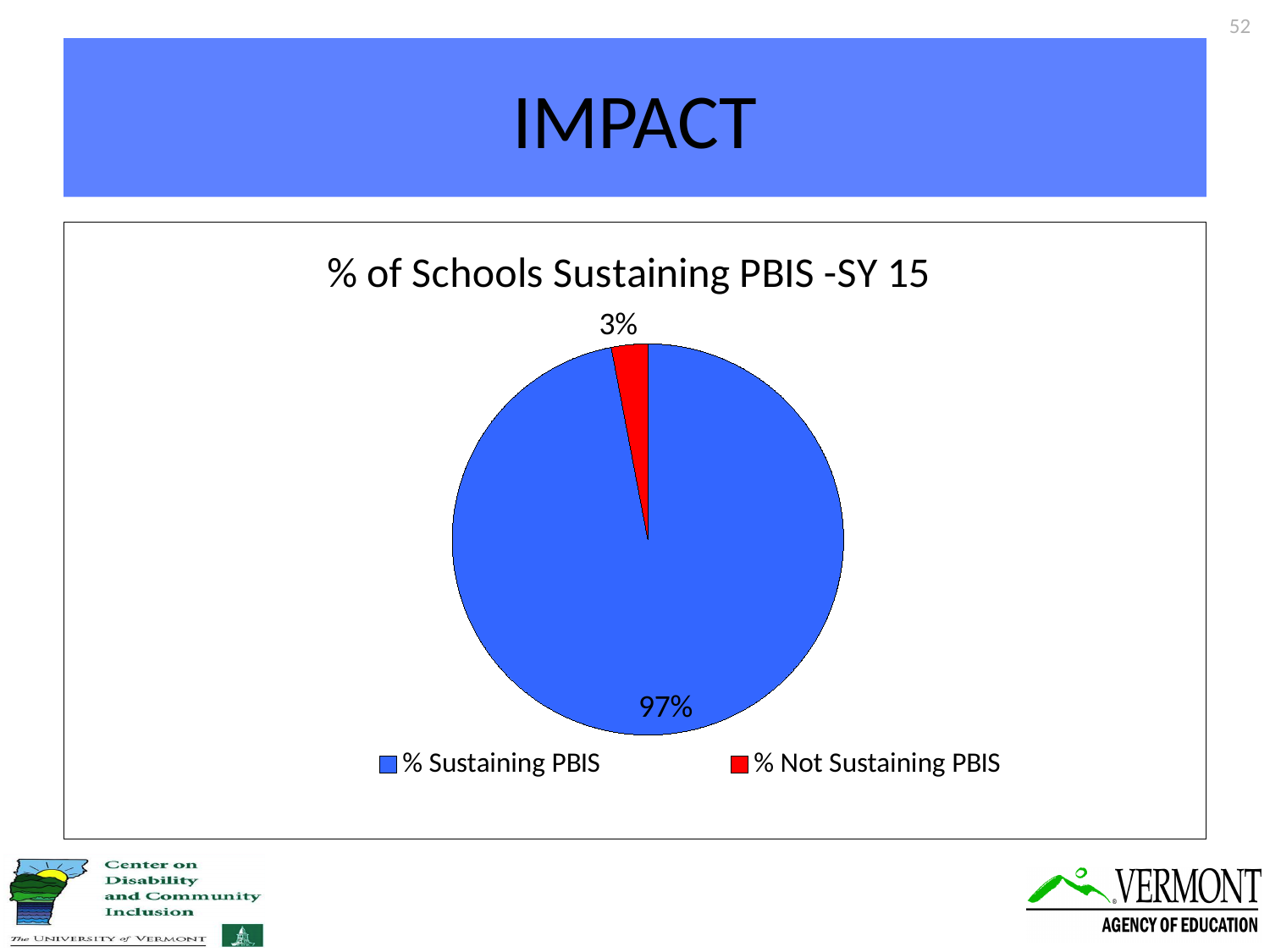
What percentage of schools are sustaining PBIS? 97% What percentage of schools are not sustaining PBIS? 3% Which is larger, the % Sustaining PBIS slice or the % Not Sustaining PBIS slice? % Sustaining PBIS What kind of chart is shown on the slide? pie chart Which slice is the largest? % Sustaining PBIS Which slice is the smallest? % Not Sustaining PBIS What is the difference between the % Sustaining PBIS slice and the % Not Sustaining PBIS slice? 94% What share of the pie does the % Sustaining PBIS slice represent? 97% How many slices does the pie chart have? 2 How many entries does the legend list? 2 What colour is the % Not Sustaining PBIS slice? red What is the title of the chart? % of Schools Sustaining PBIS -SY 15